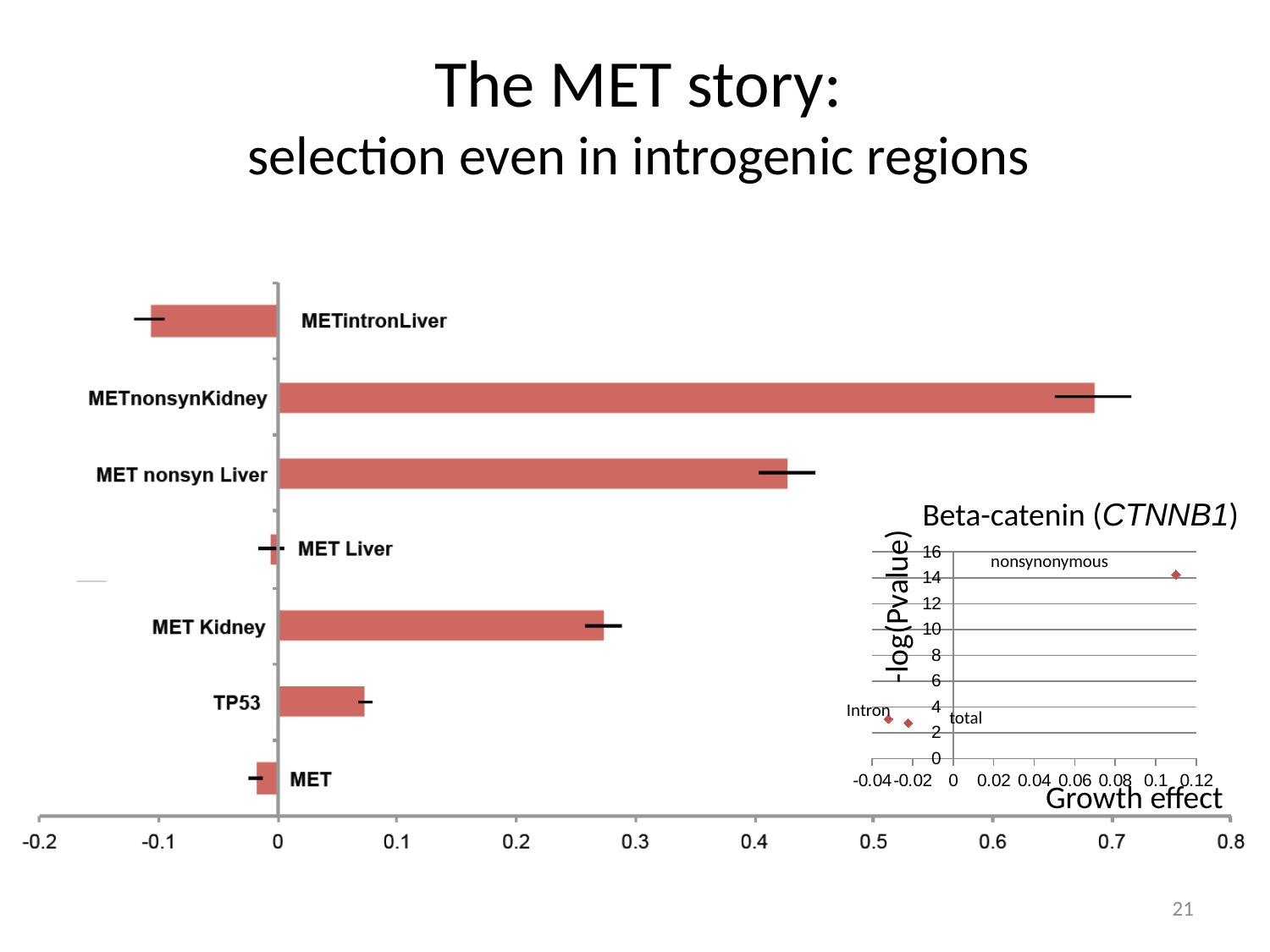
In the Beta-catenin (CTNNB1) chart, which point has the highest -log(Pvalue)? nonsynonymous In the Beta-catenin (CTNNB1) chart, how many data points are plotted? 3 In the bar chart on the left, is the value for MET Kidney greater or less than 0.3? less In the bar chart on the left, is the value for TP53 greater or less than 0.1? less In the bar chart on the left, is the value for METnonsynKidney greater or less than 0.6? greater In the bar chart on the left, which is larger: MET nonsyn Liver or MET Kidney? MET nonsyn Liver In the bar chart on the left, which category has the highest value? METnonsynKidney In the Beta-catenin (CTNNB1) chart, what is the label of the x axis? Growth effect In the bar chart on the left, which category has the lowest value? METintronLiver In the bar chart on the left, how many categories are plotted? 7 What kind of chart is the Beta-catenin (CTNNB1) chart? scatter chart What kind of chart is the large chart on the left of the slide? bar chart